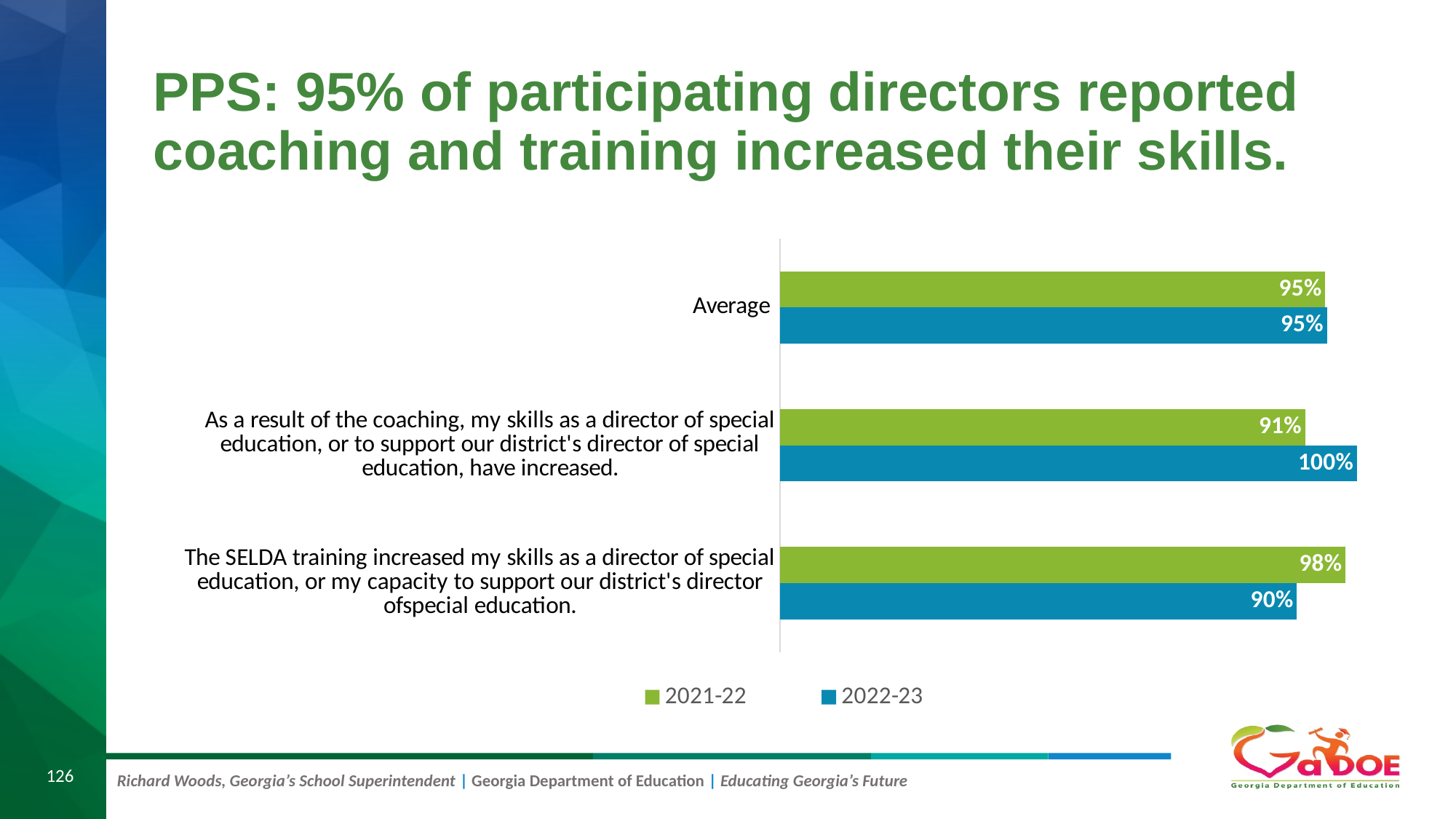
What kind of chart is shown on the slide? Bar chart How many categories are shown on the chart? 3 Which category has the lowest 2021-22 value? As a result of the coaching, my skills as a director of special education, or to support our district's director of special education, have increased. What is the difference between the 2022-23 and 2021-22 values for the coaching statement? 9% For the SELDA training statement, which series has the larger value, 2021-22 or 2022-23? 2021-22 What is the 2021-22 value for the Average category? 95% What is the 2021-22 value for the statement about the SELDA training increasing skills? 98% What is the 2022-23 value for the statement about the SELDA training increasing skills? 90% What is the 2022-23 value for the statement about coaching increasing skills as a director of special education? 100% Which colour represents the 2022-23 series in the legend? Blue Which category has the highest 2022-23 value? As a result of the coaching, my skills as a director of special education, or to support our district's director of special education, have increased. How many series does the legend list? 2